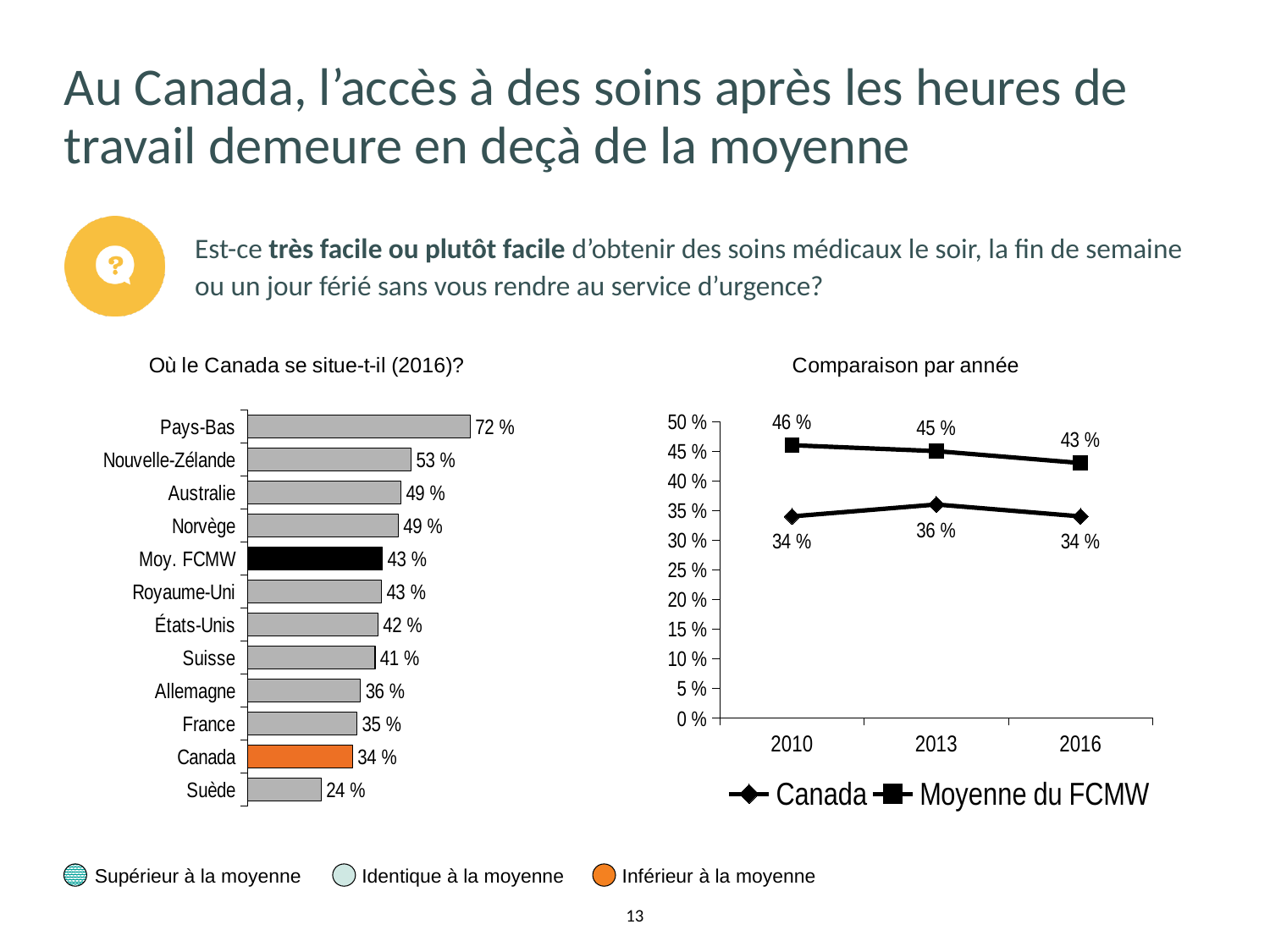
In the chart 'Comparaison par année', does the Moyenne du FCMW series rise or fall from 2010 to 2016? Fall In the chart 'Où le Canada se situe-t-il (2016)?', what is the value for Pays-Bas? 72 % In the chart 'Où le Canada se situe-t-il (2016)?', what is the value for Canada? 34 % In the chart 'Comparaison par année', what is the value for Canada in 2013? 36 % In the chart 'Où le Canada se situe-t-il (2016)?', how many categories are shown? 12 In the chart 'Comparaison par année', what is the value for Moyenne du FCMW in 2010? 46 % In the chart 'Où le Canada se situe-t-il (2016)?', which category has the highest value? Pays-Bas In the chart 'Où le Canada se situe-t-il (2016)?', what is the difference between Pays-Bas and Canada? 38 % In the chart 'Comparaison par année', how many series does the legend list? 2 What kind of chart is 'Où le Canada se situe-t-il (2016)?' Bar chart In the chart 'Comparaison par année', what is the difference between Moyenne du FCMW and Canada in 2016? 9 % In the chart 'Où le Canada se situe-t-il (2016)?', which country has the lowest value? Suède